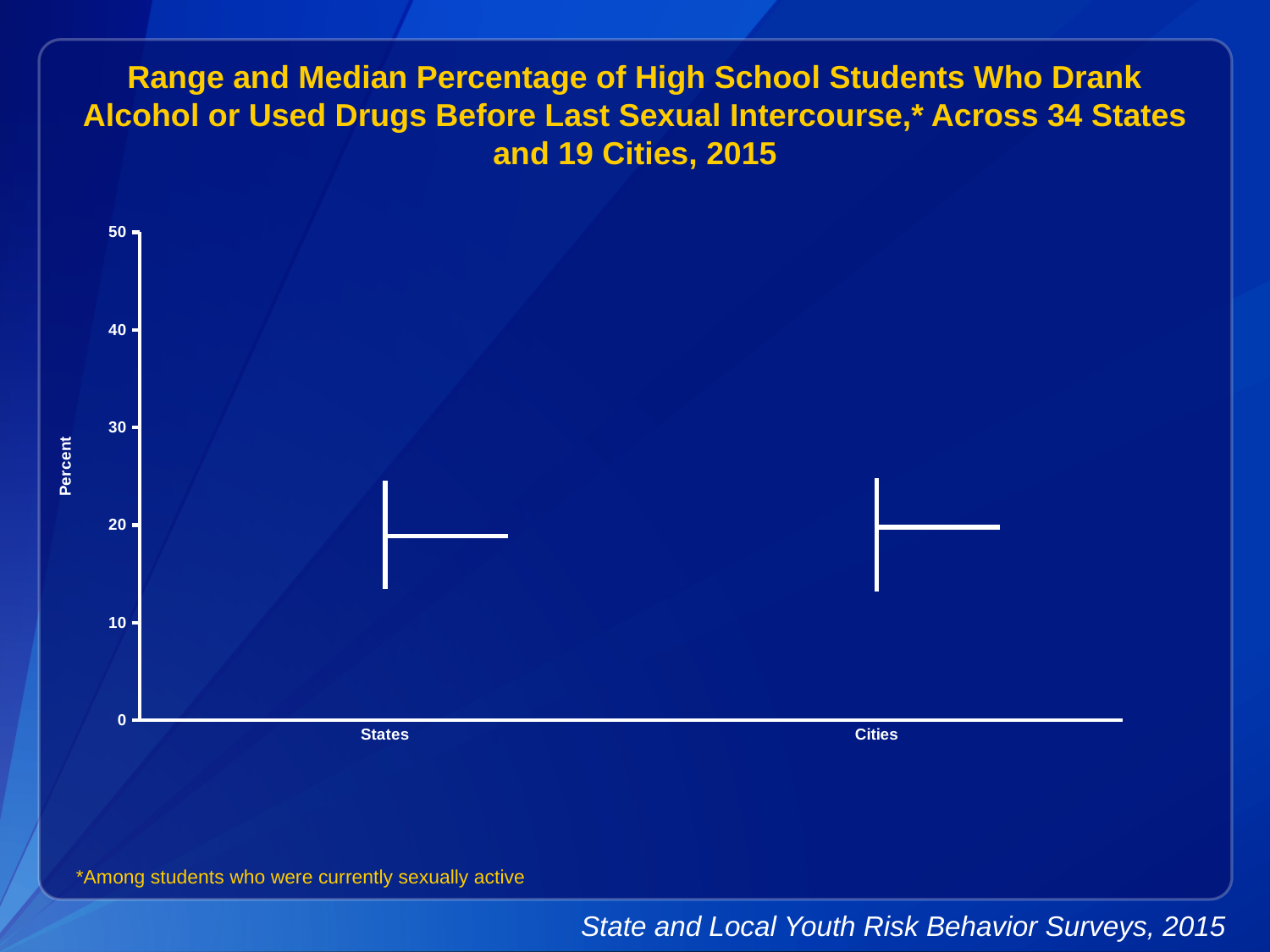
What is the highest value shown on the y axis? 50 Is the median value for States greater or less than 10? greater Is the bottom of the range for Cities greater or less than 10? greater What is the label on the y axis of the chart? Percent Is the top of the range for States greater or less than 30? less How many categories are shown on the x axis of the chart? 2 What are the two categories shown on the x axis? States and Cities